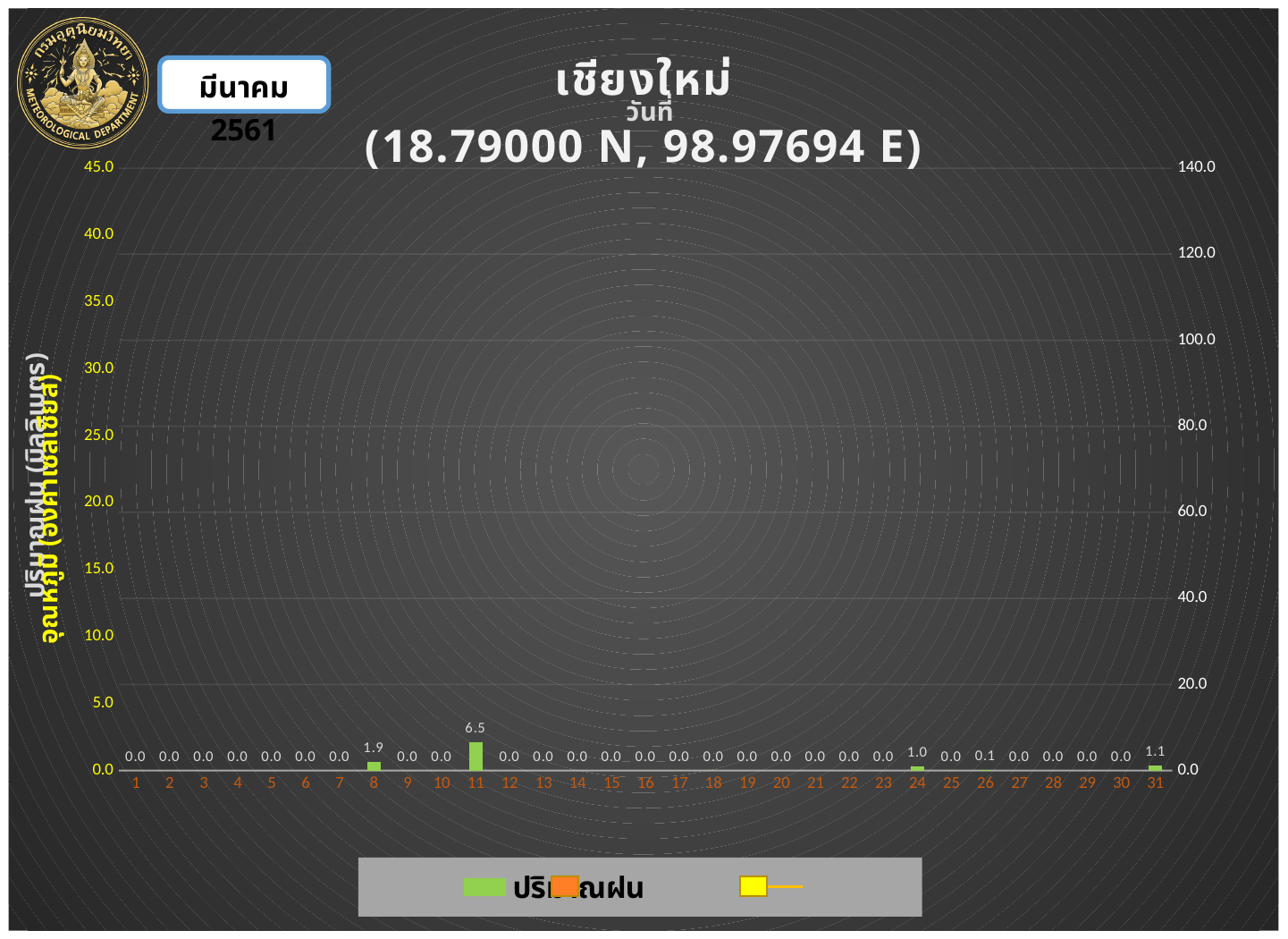
What is the difference between the rainfall values for day 11 and day 8? 4.6 What is the rainfall value plotted for day 26? 0.1 What kind of chart is used to show the rainfall values? Bar chart What is the rainfall value plotted for day 31? 1.1 Which day has the highest rainfall value on the chart? 11 What is the rainfall value plotted for day 8? 1.9 Which day has the larger rainfall value, day 8 or day 31? Day 8 What is the rainfall value plotted for day 24? 1.0 What is the rainfall value plotted for day 11? 6.5 Is the rainfall value for day 11 greater or less than 10.0 on the left axis? less What coordinates are given in the chart title? 18.79000 N, 98.97694 E How many days are shown along the x axis of the chart? 31